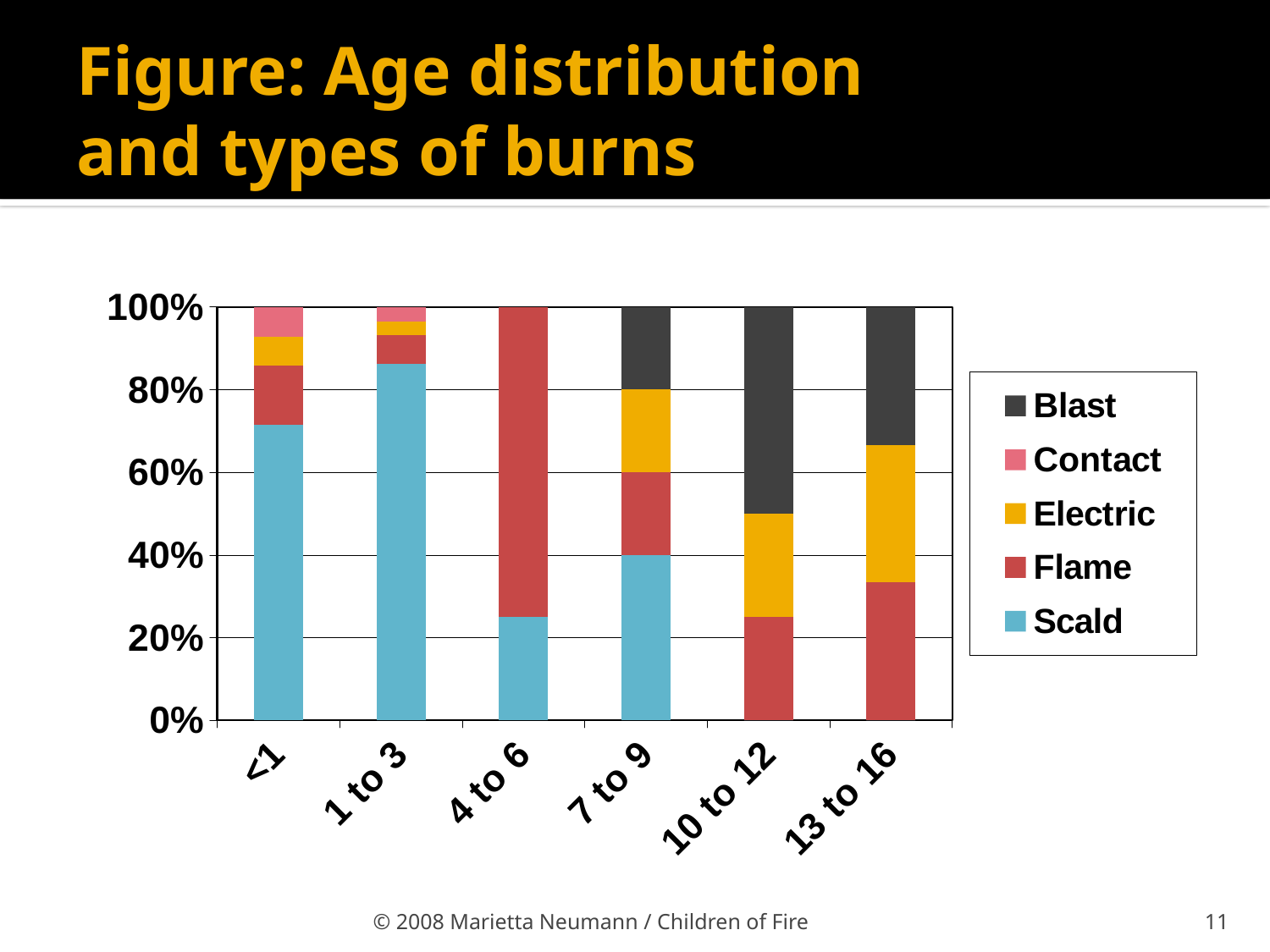
Is the Blast share for the 13 to 16 age group greater or less than 40%? less Which series is shown in the legend with a blue colour? Scald Is the Flame share for the 4 to 6 age group greater or less than 60%? greater How many age categories are shown on the x axis? 6 How many series does the legend list? 5 Which age group has the larger Scald share, <1 or 7 to 9? <1 Is the Scald share for the 1 to 3 age group greater or less than 80%? greater Which age group has the largest Flame share? 4 to 6 Which age group has the largest Scald share? 1 to 3 What kind of chart is shown on the slide? Stacked bar chart Which age group has the larger Blast share, 10 to 12 or 13 to 16? 10 to 12